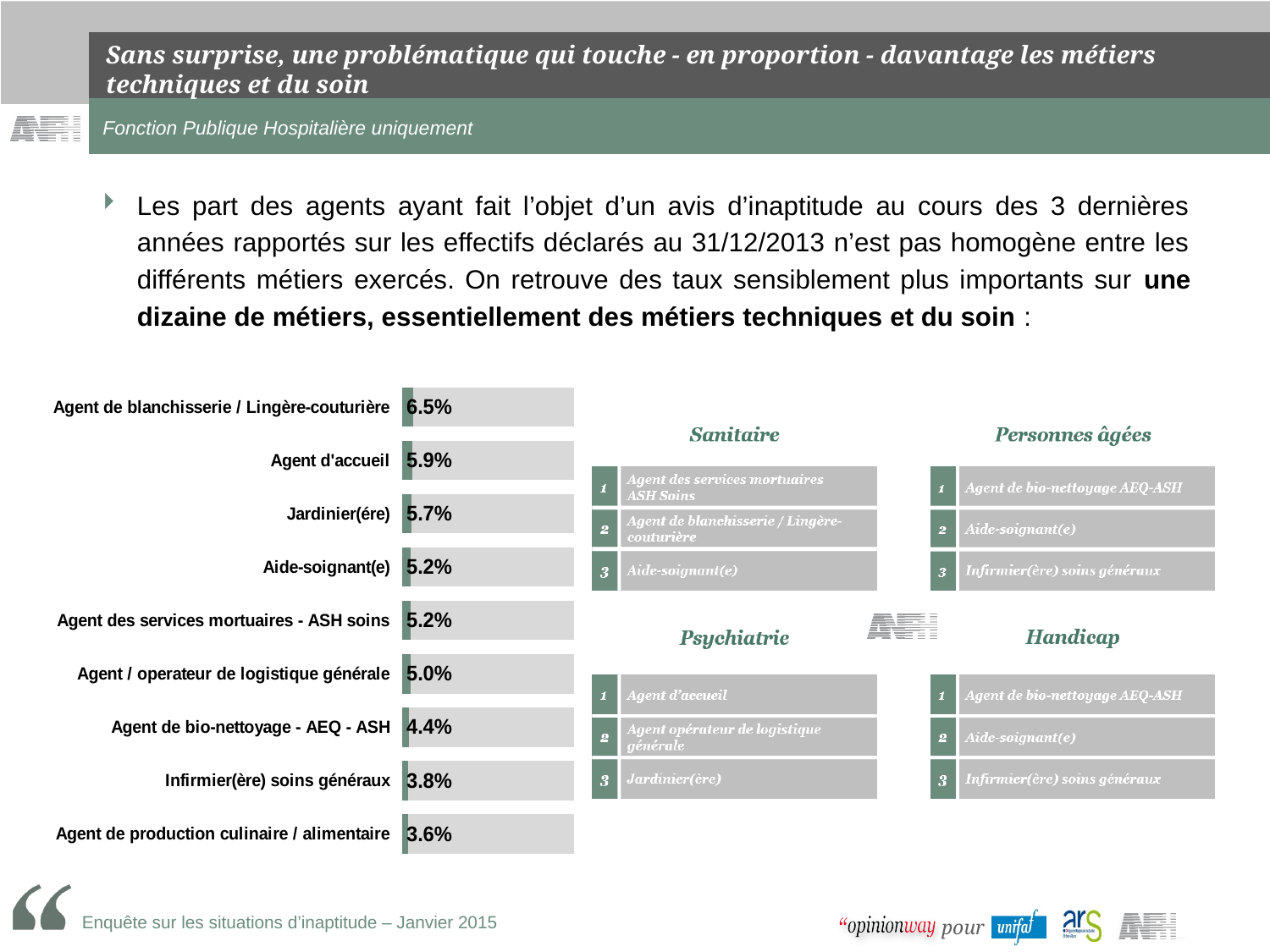
Which has a larger value, Agent d'accueil or Agent / operateur de logistique générale? Agent d'accueil What is the value shown for Infirmier(ère) soins généraux? 3.8% What is the difference between the values for Agent d'accueil and Agent de production culinaire / alimentaire? 2.3% What is the value shown for Agent de blanchisserie / Lingère-couturière? 6.5% Which category has the highest value in the bar chart? Agent de blanchisserie / Lingère-couturière How many categories are shown in the bar chart? 9 What is the value shown for Jardinier(ére)? 5.7% What kind of chart is shown on the slide? Bar chart Which category has the lowest value in the bar chart? Agent de production culinaire / alimentaire What is the difference between the values for Agent de blanchisserie / Lingère-couturière and Aide-soignant(e)? 1.3% Do the values in the bar chart rise or fall from the top category to the bottom category? Fall What is the value shown for Agent de bio-nettoyage - AEQ - ASH? 4.4%